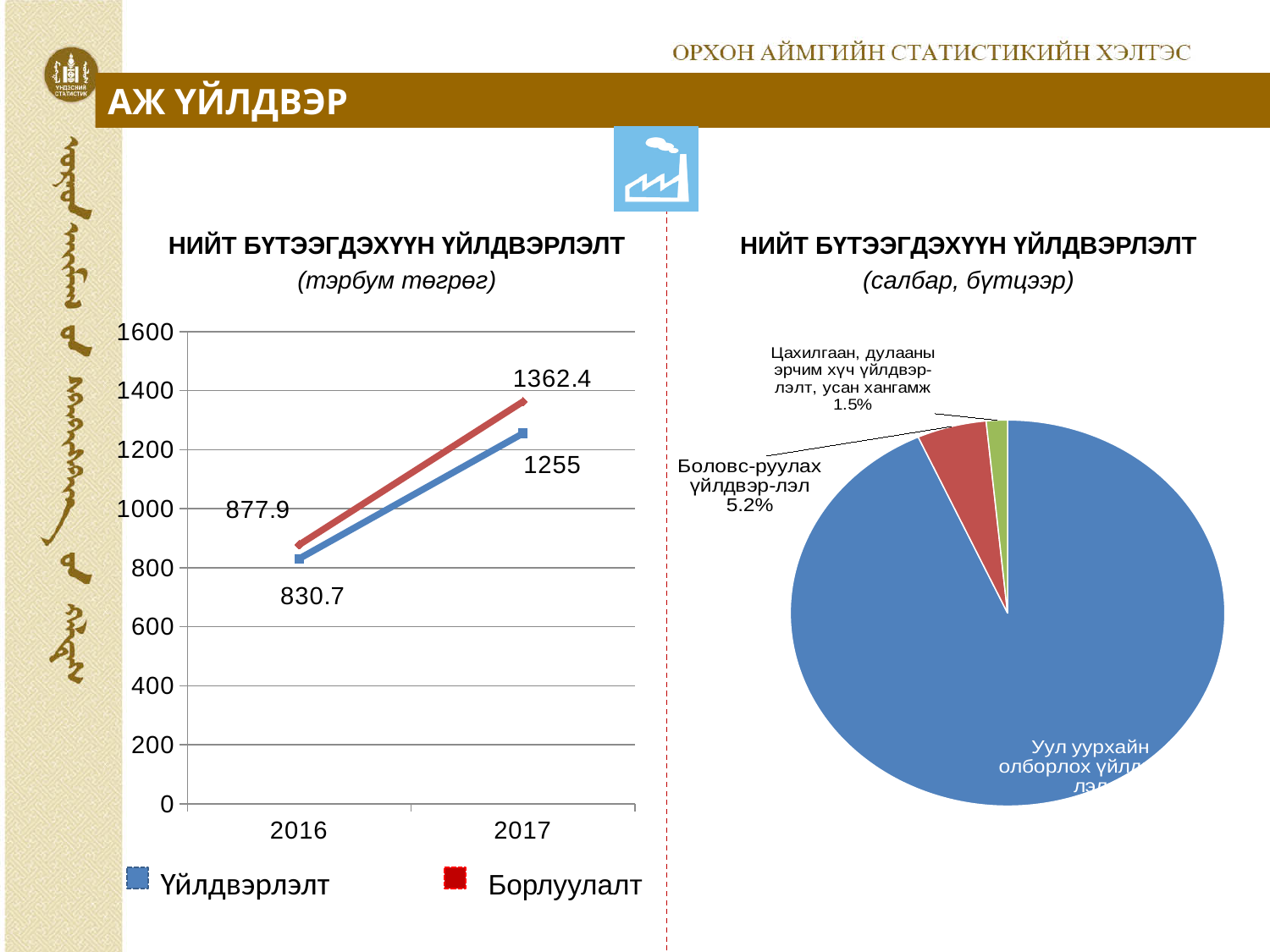
In the left line chart (тэрбум төгрөг), what is the difference between Борлуулалт and Үйлдвэрлэлт in 2017? 107.4 In the left line chart (тэрбум төгрөг), what is the value of Борлуулалт in 2017? 1362.4 What kind of chart is the left chart (тэрбум төгрөг)? line chart In the left line chart (тэрбум төгрөг), does Үйлдвэрлэлт rise or fall from 2016 to 2017? rise In the left line chart (тэрбум төгрөг), what is the value of Борлуулалт in 2016? 877.9 In the right pie chart (салбар, бүтцээр), what share does Цахилгаан, дулааны эрчим хүч үйлдвэрлэлт, усан хангамж have? 1.5% In the left line chart (тэрбум төгрөг), what is the value of Үйлдвэрлэлт in 2017? 1255 In the left line chart (тэрбум төгрөг), which series has the higher value in 2016, Үйлдвэрлэлт or Борлуулалт? Борлуулалт In the right pie chart (салбар, бүтцээр), what share does Боловсруулах үйлдвэрлэл have? 5.2% How many series does the legend of the left line chart (тэрбум төгрөг) list? 2 In the left line chart (тэрбум төгрөг), by how much did Үйлдвэрлэлт increase from 2016 to 2017? 424.3 How many slices does the right pie chart (салбар, бүтцээр) have? 3